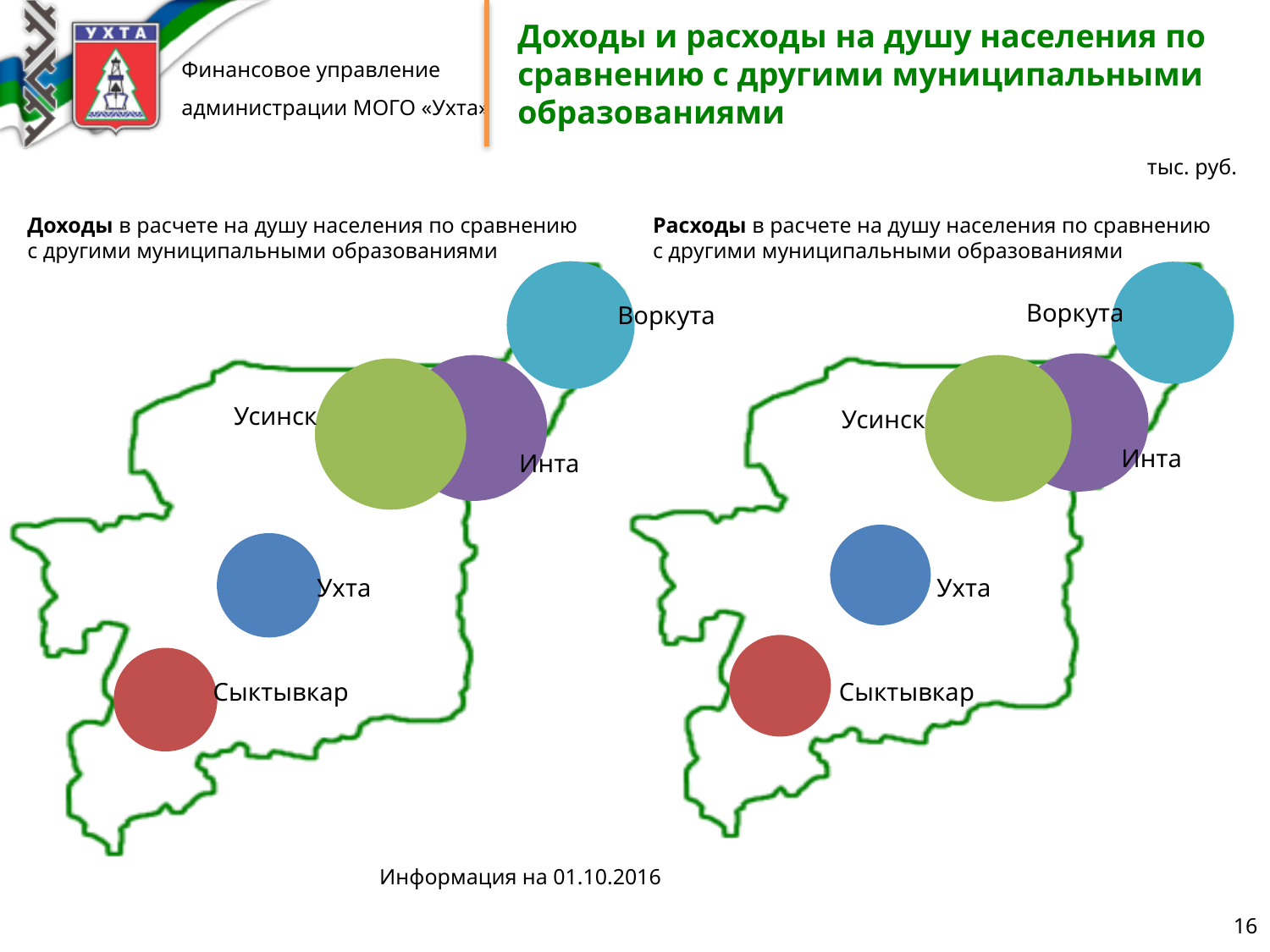
On the left chart (Доходы), which bubble is larger: Воркута or Ухта? Воркута On the right chart (Расходы), which bubble is larger: Усинск or Сыктывкар? Усинск What kind of chart is used on the left (Доходы) side of the slide? Bubble chart What unit of measurement is stated for the charts on the slide? тыс. руб. What colour is the bubble for Ухта on both charts? Blue On the left chart (Доходы), which bubble is larger: Усинск or Ухта? Усинск How many municipalities are shown as bubbles on the right chart (Расходы в расчете на душу населения)? 5 How many municipalities are shown as bubbles on the left chart (Доходы в расчете на душу населения)? 5